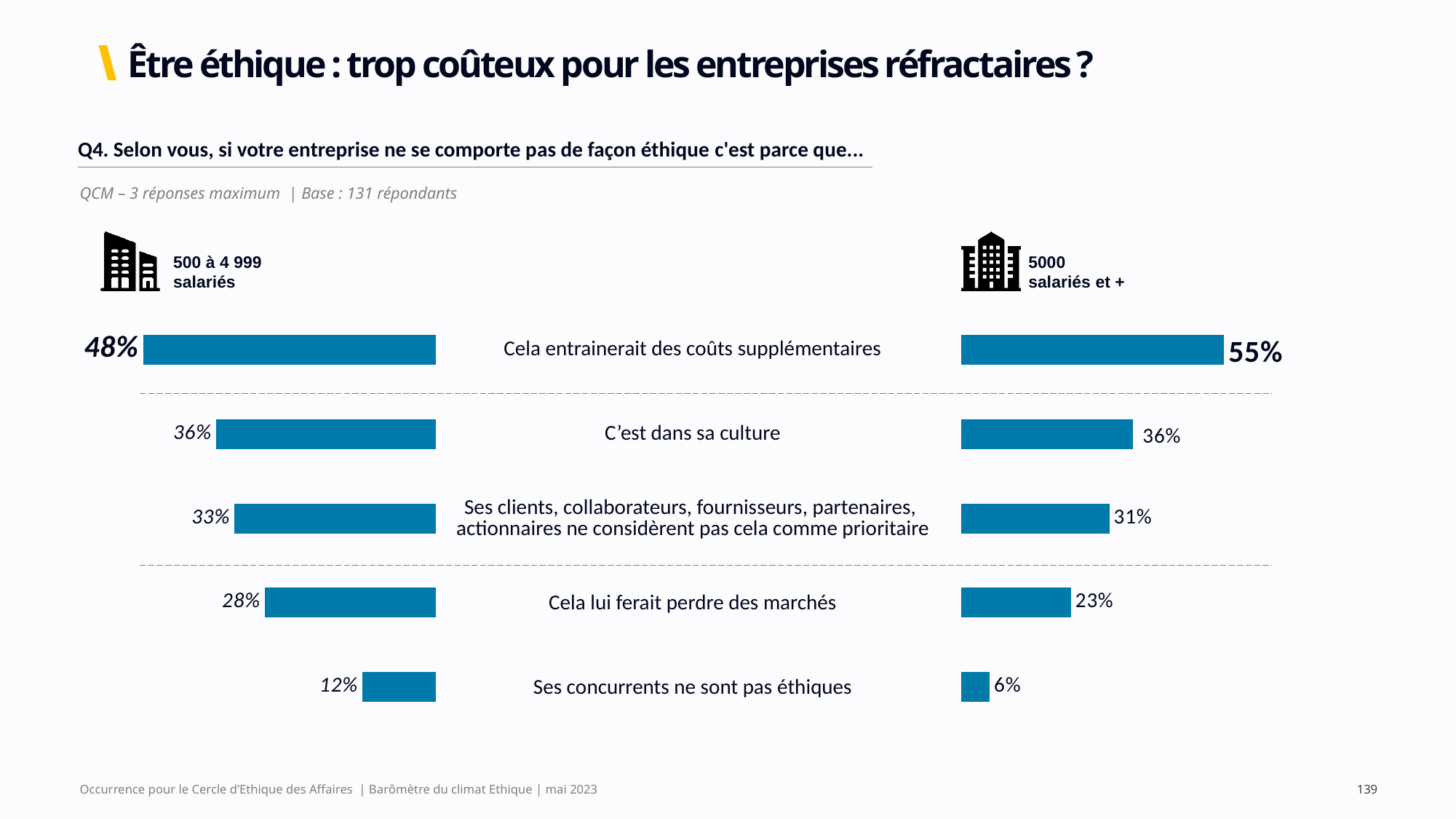
What kind of chart is used on this slide? Bar chart In the chart for 5000 salariés et +, what is the value for "Cela lui ferait perdre des marchés"? 23% In the chart for 500 à 4 999 salariés, what is the value for "Cela entrainerait des coûts supplémentaires"? 48% What is the value for "C'est dans sa culture" in the chart for 5000 salariés et +? 36% What is the difference between the 5000 salariés et + value and the 500 à 4 999 salariés value for "Cela entrainerait des coûts supplémentaires"? 7 percentage points How many categories are shown in the chart for 500 à 4 999 salariés? 5 In the chart for 5000 salariés et +, what is the value for "Cela entrainerait des coûts supplémentaires"? 55% In the chart for 500 à 4 999 salariés, which category has the highest value? Cela entrainerait des coûts supplémentaires In the chart for 5000 salariés et +, which category has the lowest value? Ses concurrents ne sont pas éthiques For "Cela lui ferait perdre des marchés", which group has the larger value: 500 à 4 999 salariés or 5000 salariés et +? 500 à 4 999 salariés In the chart for 500 à 4 999 salariés, what is the value for "Ses concurrents ne sont pas éthiques"? 12% In the chart for 500 à 4 999 salariés, what is the difference between "C'est dans sa culture" and "Ses concurrents ne sont pas éthiques"? 24 percentage points